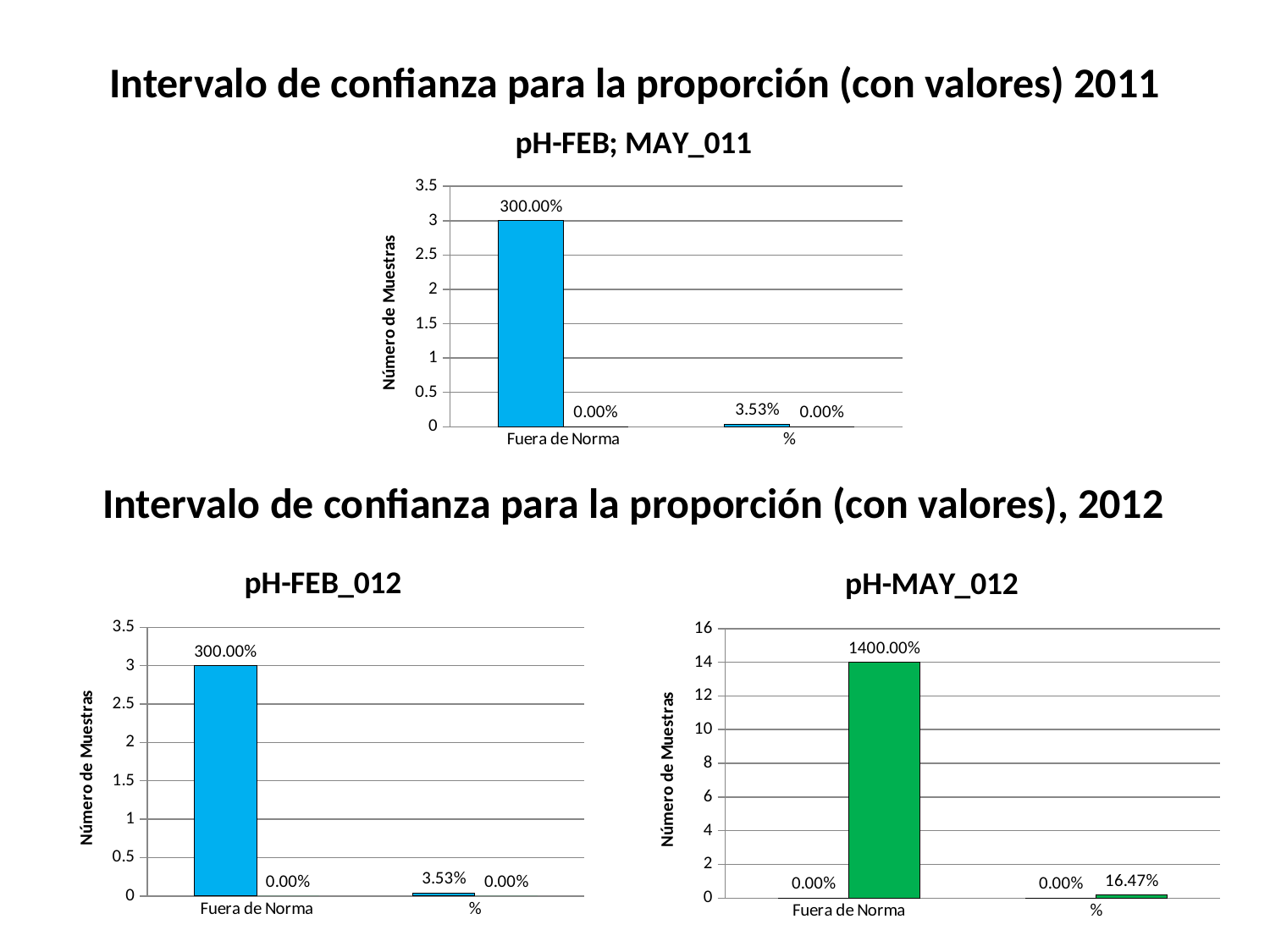
In the pH-MAY_012 chart, is the tall bar for Fuera de Norma greater or less than 10 on the y axis? greater In the pH-MAY_012 chart, which category has the tallest bar? Fuera de Norma In the pH-MAY_012 chart, what is the larger data label shown for the % category? 16.47% What is the y-axis title of the pH-FEB_012 chart? Número de Muestras What kind of chart is the pH-MAY_012 chart? Bar chart In the pH-MAY_012 chart, what data label is shown on the tall bar for Fuera de Norma? 1400.00% In the pH-FEB; MAY_011 chart, what data label is shown on the tall bar for Fuera de Norma? 300.00% What is the highest value shown on the y axis of the pH-MAY_012 chart? 16 How many categories are shown on the x axis of the pH-FEB_012 chart? 2 In the pH-FEB_012 chart, what data label is shown on the tall bar for Fuera de Norma? 300.00% In the pH-FEB; MAY_011 chart, what is the larger data label shown for the % category? 3.53% In the pH-FEB; MAY_011 chart, which is larger: the tall bar for Fuera de Norma or the bar for %? Fuera de Norma